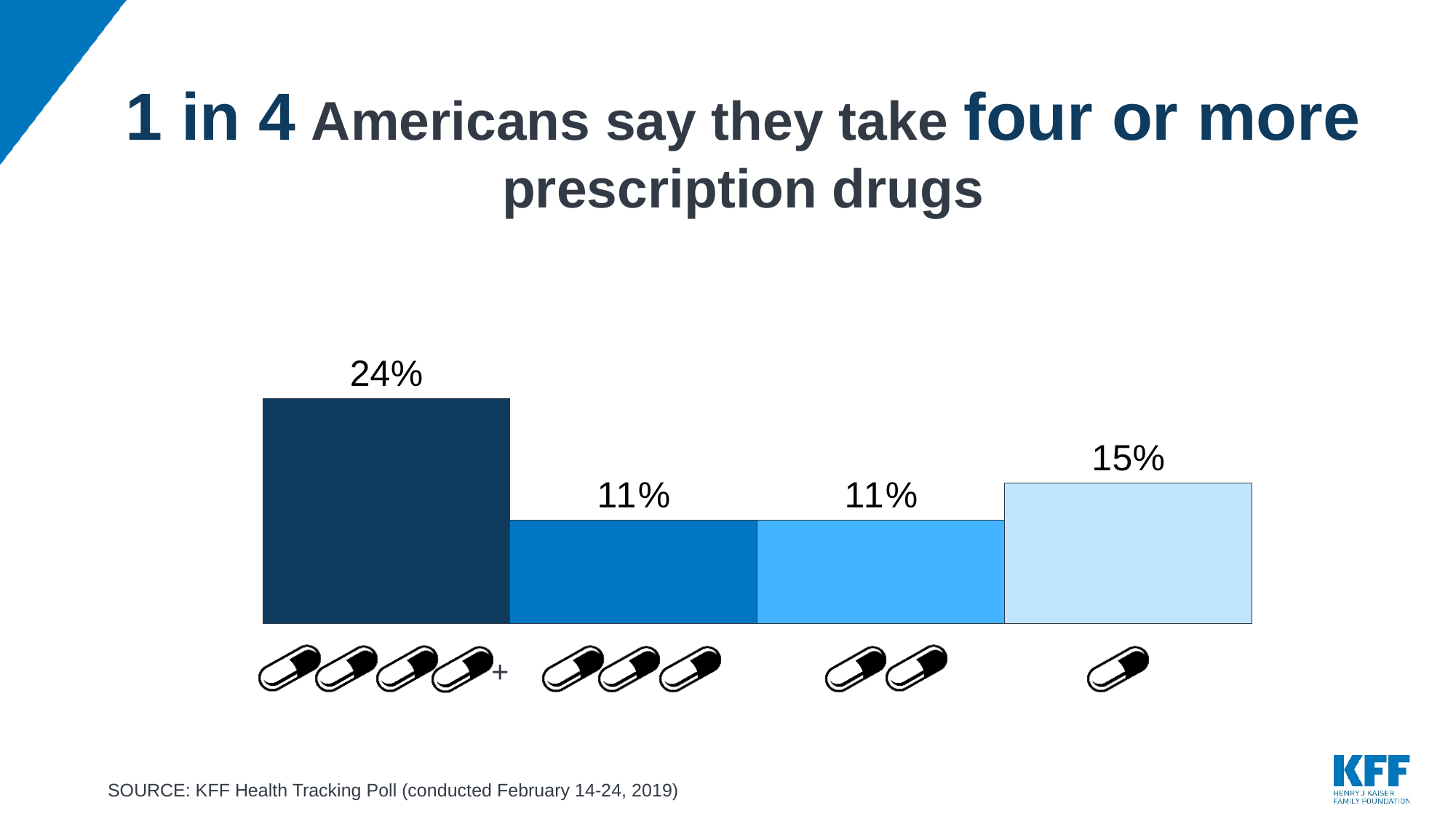
What is the total of the four percentages shown on the bars? 61% What value is shown for the bar labelled with three pill icons? 11% What percentage of Americans say they take four or more prescription drugs, according to the bar with four pill icons and a plus sign? 24% Which bar has the highest value? Four or more pills (24%) What is the title of the slide? 1 in 4 Americans say they take four or more prescription drugs What kind of chart is shown on the slide? Bar chart Which is larger, the value for one pill or the value for two pills? One pill What value is shown for the bar labelled with a single pill icon? 15% How many bars are shown in the chart? 4 What is the difference between the value for four or more pills and the value for one pill? 9% What is the difference between the value for one pill and the value for two pills? 4% Do the two bars labelled with three pills and two pills have the same value? Yes, both 11%